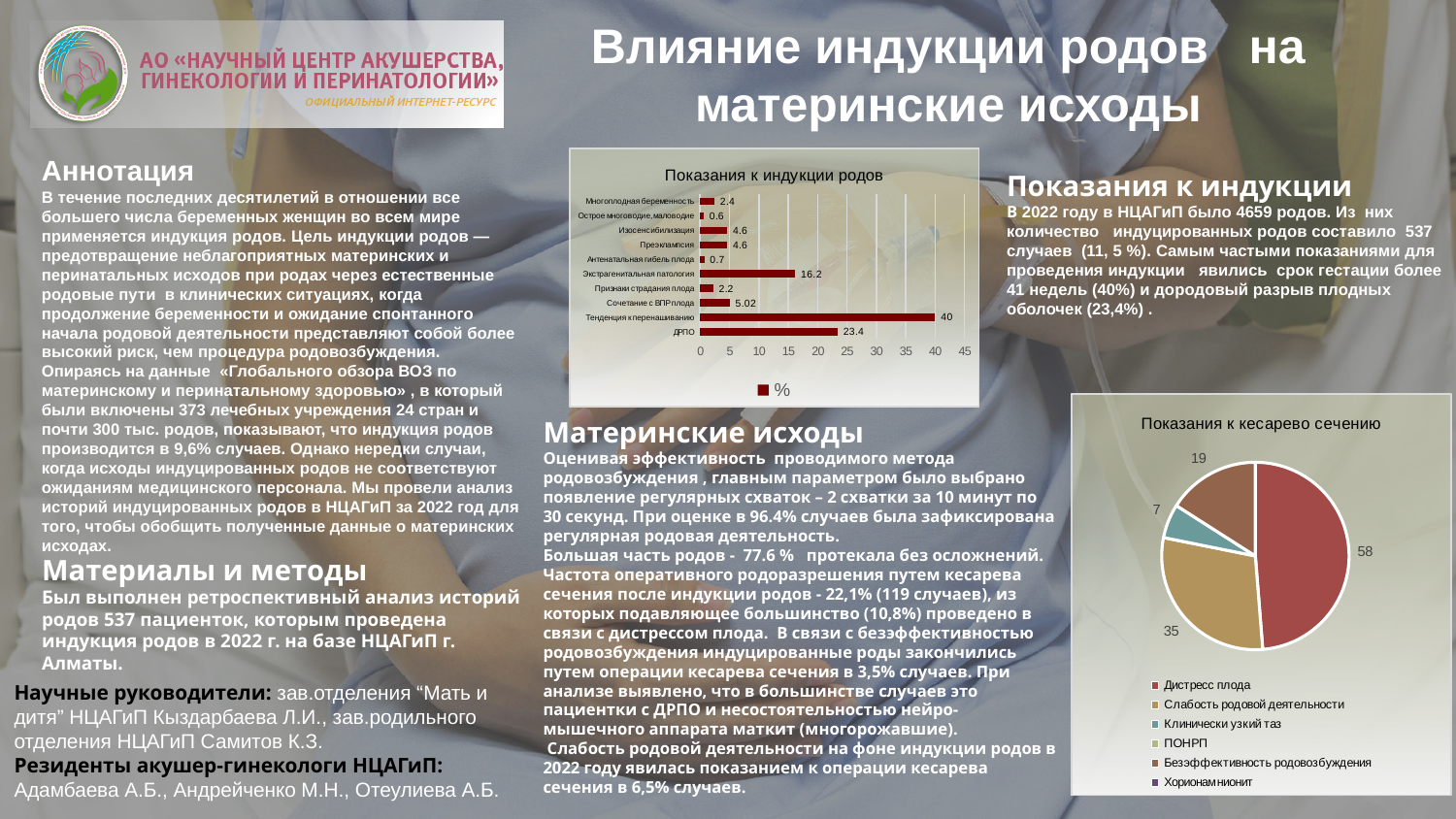
In the chart titled "Показания к индукции родов", what is the value for Тенденция к перенашиванию? 40 In the chart titled "Показания к кесарево сечению", how many entries does the legend list? 6 In the chart titled "Показания к индукции родов", what is the value for Экстрагенитальная патология? 16.2 In the chart titled "Показания к индукции родов", what is the difference between the values for Тенденция к перенашиванию and ДРПО? 16.6 In the chart titled "Показания к индукции родов", what is the value for ДРПО? 23.4 In the chart titled "Показания к индукции родов", which category has the highest value? Тенденция к перенашиванию In the chart titled "Показания к индукции родов", which category has the lowest value? Острое многоводие, маловодие In the chart titled "Показания к индукции родов", how many categories are plotted? 10 What type of chart is the chart titled "Показания к индукции родов"? Bar chart What type of chart is the chart titled "Показания к кесарево сечению"? Pie chart In the chart titled "Показания к кесарево сечению", what is the value of the largest slice? 58 In the chart titled "Показания к индукции родов", which is larger: Сочетание с ВПР плода or Многоплодная беременность? Сочетание с ВПР плода